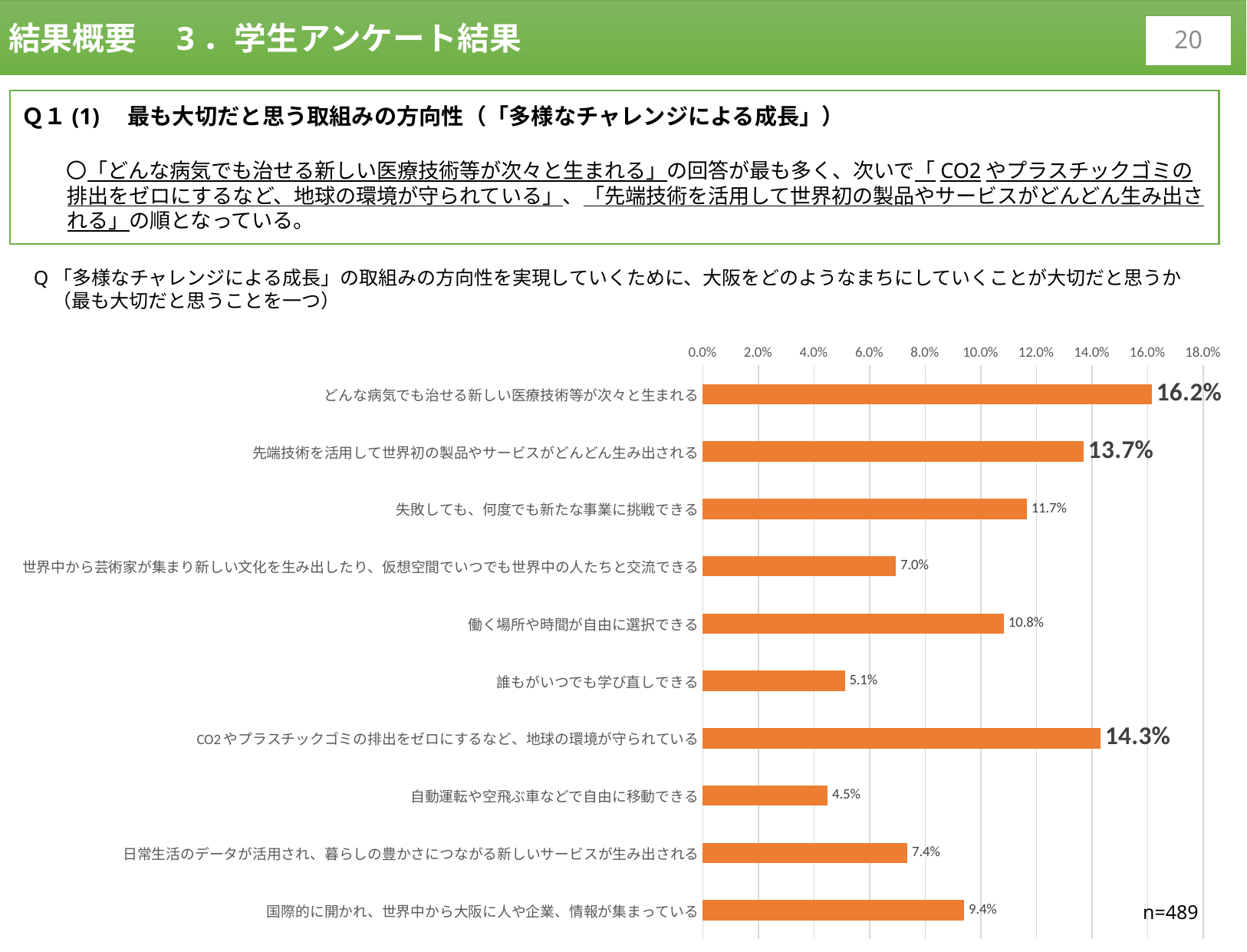
Which is larger: the value for 「失敗しても、何度でも新たな事業に挑戦できる」 or 「働く場所や時間が自由に選択できる」? 失敗しても、何度でも新たな事業に挑戦できる What is the sample size (n) shown on the chart? n=489 What kind of chart is shown on the slide? bar chart Is the value for 「誰もがいつでも学び直しできる」 greater or less than 6.0%? less What is the value for 「国際的に開かれ、世界中から大阪に人や企業、情報が集まっている」? 9.4% How many categories are shown in the bar chart? 10 What is the value for 「働く場所や時間が自由に選択できる」? 10.8% Which category has the lowest value? 自動運転や空飛ぶ車などで自由に移動できる What is the maximum value shown on the chart's percentage axis? 18.0% Which category has the highest value? どんな病気でも治せる新しい医療技術等が次々と生まれる What is the difference between the values for 「CO2やプラスチックゴミの排出をゼロにするなど、地球の環境が守られている」 and 「先端技術を活用して世界初の製品やサービスがどんどん生み出される」? 0.6% What is the value for 「どんな病気でも治せる新しい医療技術等が次々と生まれる」? 16.2%